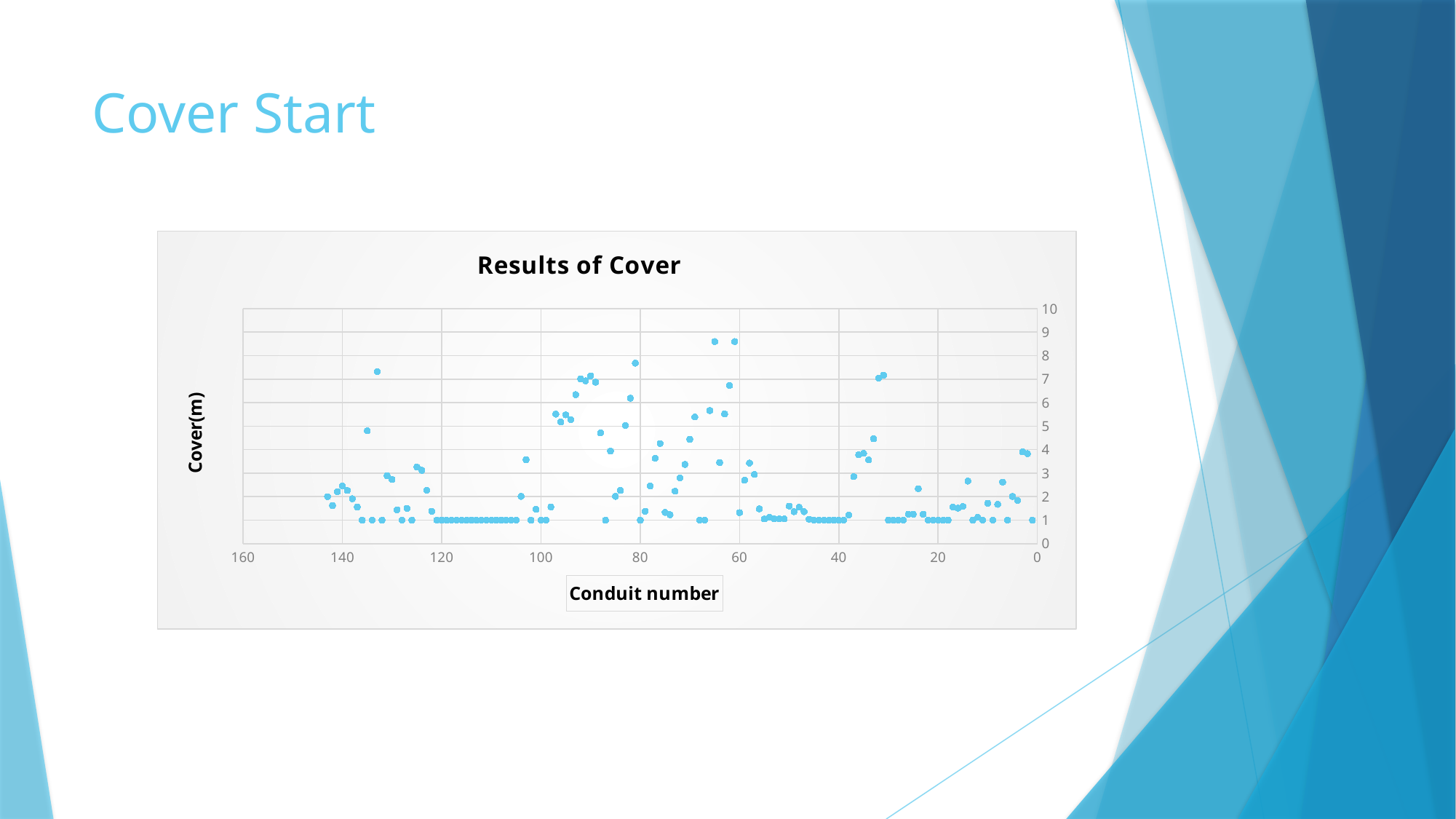
Is the highest point plotted between conduit numbers 140 and 120 greater or less than 6? greater What is the label on the vertical axis of the chart? Cover(m) Are the points plotted between conduit numbers 120 and 105 greater or less than 2? less Is the highest plotted cover value greater or less than 9? less What kind of chart is shown on the slide? scatter chart What is the title of the chart? Results of Cover